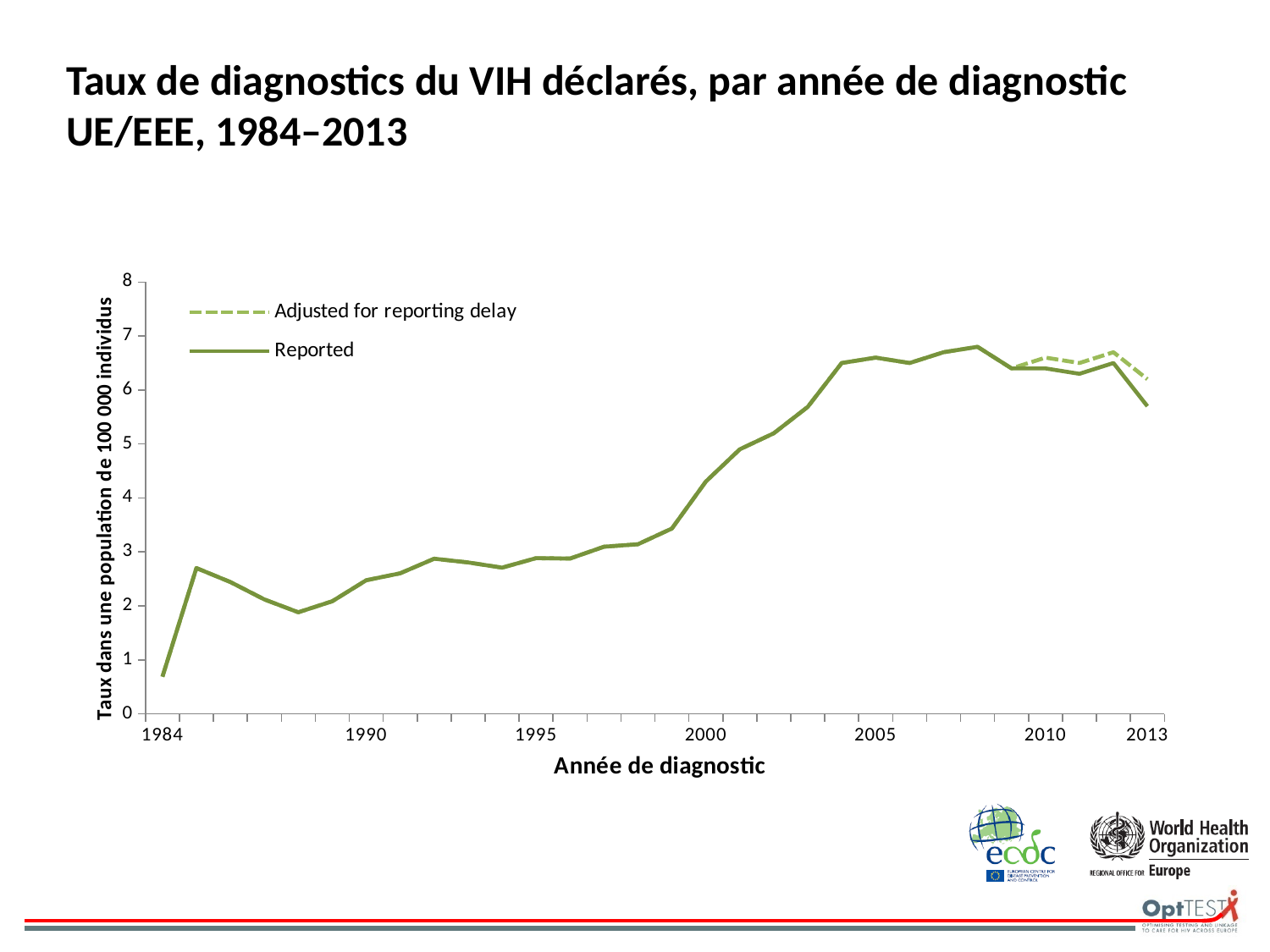
What kind of chart is shown on the slide? line chart Is the Reported value for 2005 greater or less than 6? greater Which series is drawn with a dashed line? Adjusted for reporting delay Is the Reported value for 1990 greater or less than 2? greater Is the Reported value for 1984 greater or less than 1? less In which year is the Reported rate lowest? 1984 For 2013, which is higher: the Adjusted for reporting delay value or the Reported value? Adjusted for reporting delay Which is larger, the Reported value for 1990 or for 2000? 2000 What is the label of the x axis? Année de diagnostic How many series does the legend list? 2